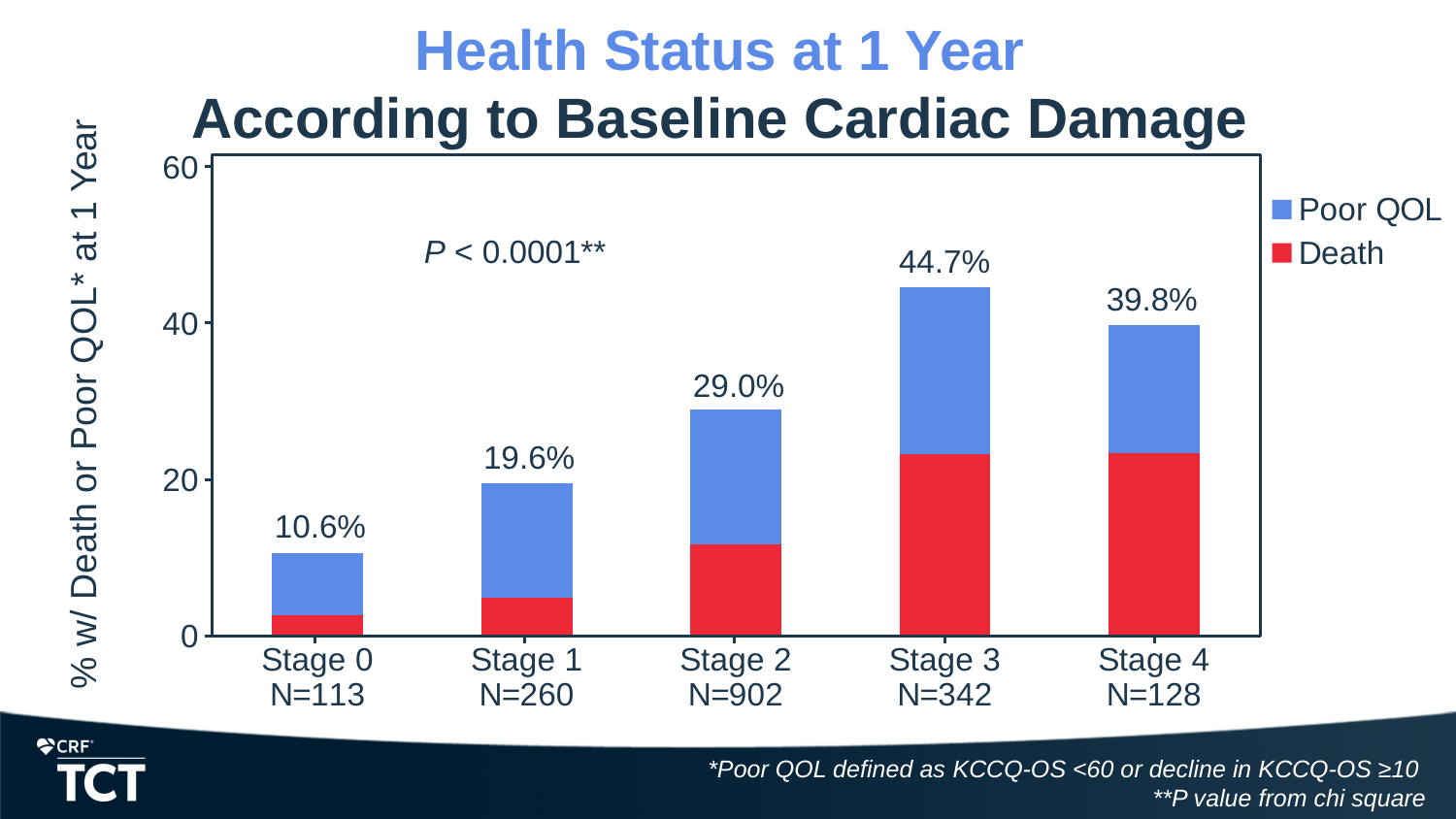
Which stage has the highest total percentage with death or poor QOL at 1 year? Stage 3 What kind of chart is shown on the slide? Stacked bar chart What is the total percentage labelled above the Stage 4 bar? 39.8% What is the total percentage labelled above the Stage 0 bar? 10.6% Which stage has the lowest total percentage with death or poor QOL at 1 year? Stage 0 What is the total percentage with death or poor QOL at 1 year for Stage 2? 29.0% Which has a larger total percentage, Stage 1 or Stage 2? Stage 2 What is the difference between the total percentages for Stage 3 and Stage 4? 4.9% Is the Death portion of the Stage 2 bar greater or less than 20? less How many series does the legend list? 2 Is the Death portion of the Stage 3 bar greater or less than 20? greater How many stages are shown on the x axis? 5